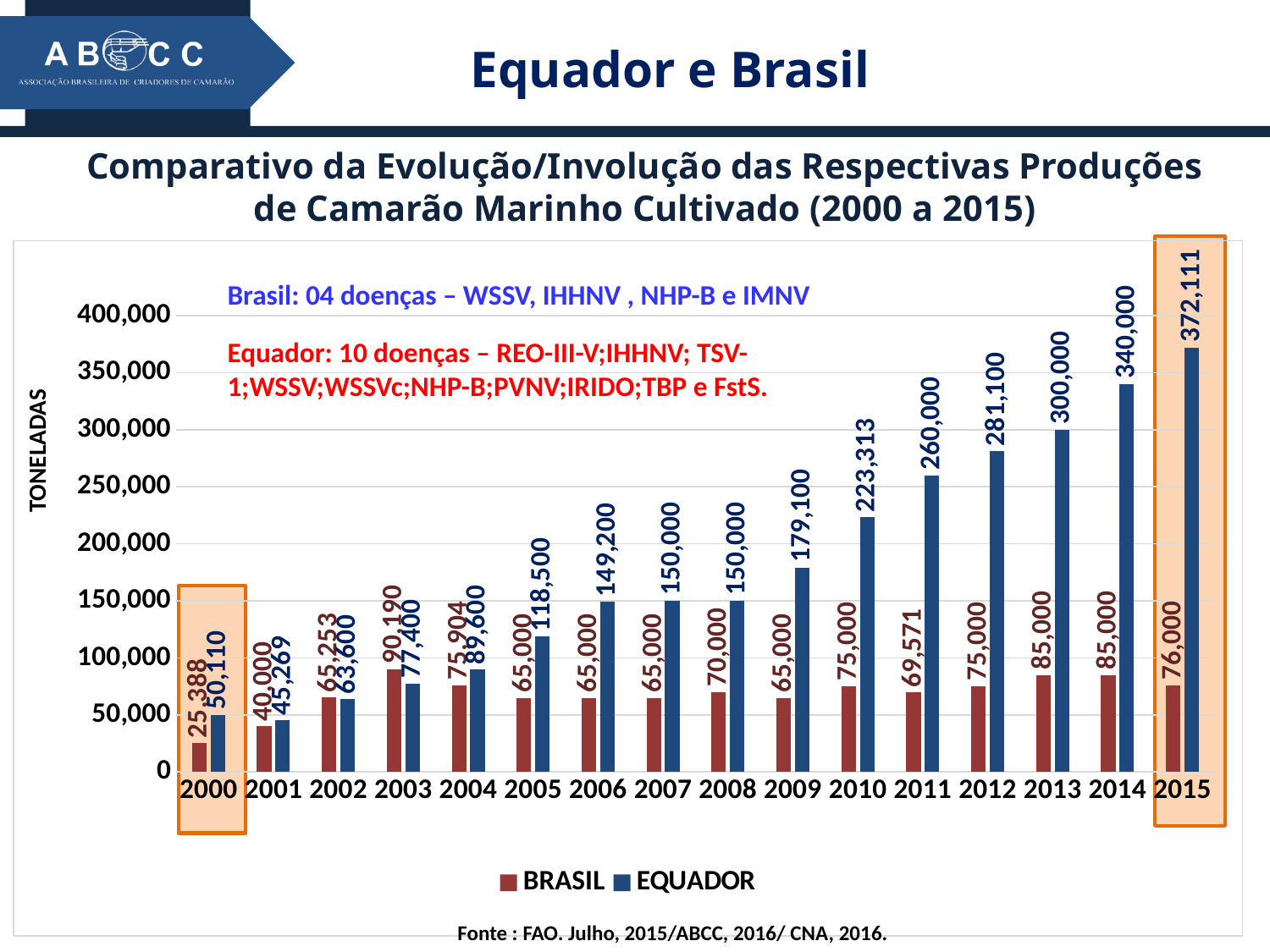
How many series does the legend list? 2 What is the difference between Equador's and Brasil's production in 2015? 296,111 What was Brasil's production in 2003? 90,190 How many years are shown on the x axis? 16 What was Brasil's production in 2000? 25,388 Which country had higher production in 2003, Brasil or Equador? Brasil In which year was Equador's production lowest? 2001 In which year was Brasil's production highest? 2003 Does Equador's production generally rise or fall from 2005 to 2015? Rise What was Equador's production in 2015? 372,111 What was Equador's production in 2010? 223,313 What kind of chart is shown on the slide? Bar chart